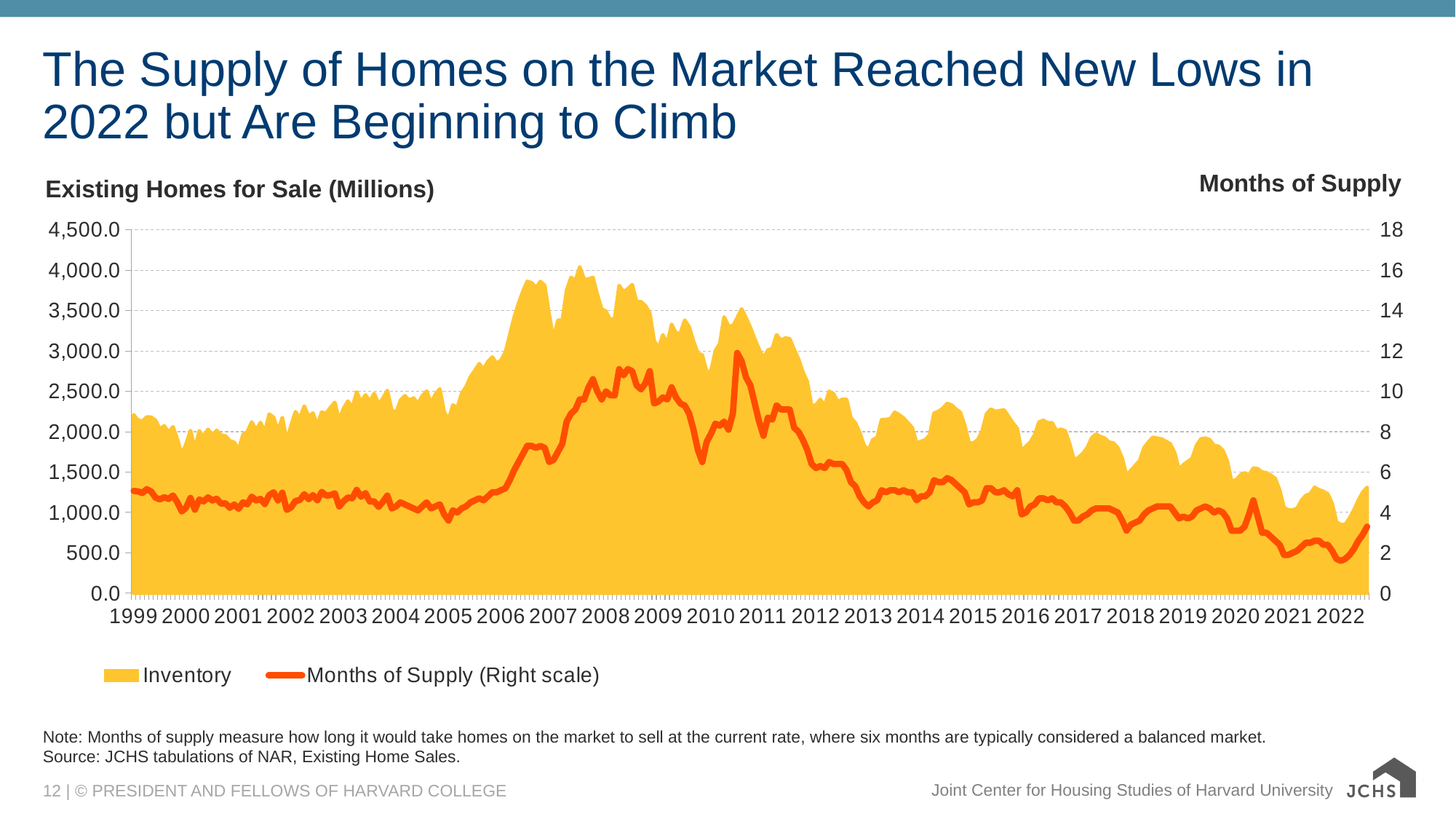
What is the title of the left axis? Existing Homes for Sale (Millions) How many years are labeled on the x axis? 24 Does Inventory rise or fall from 2005 to 2007? rise Which series is plotted on the right scale? Months of Supply Is the Months of Supply value in 2021 greater or less than 4? less Is the peak Inventory value in 2013 greater or less than 2,500.0? less What kind of chart is shown on the slide? A combined area and line chart How many series does the legend list? 2 Is the Months of Supply value at the start of 1999 greater or less than 4? greater Does Inventory generally rise or fall from 2011 to 2021? fall